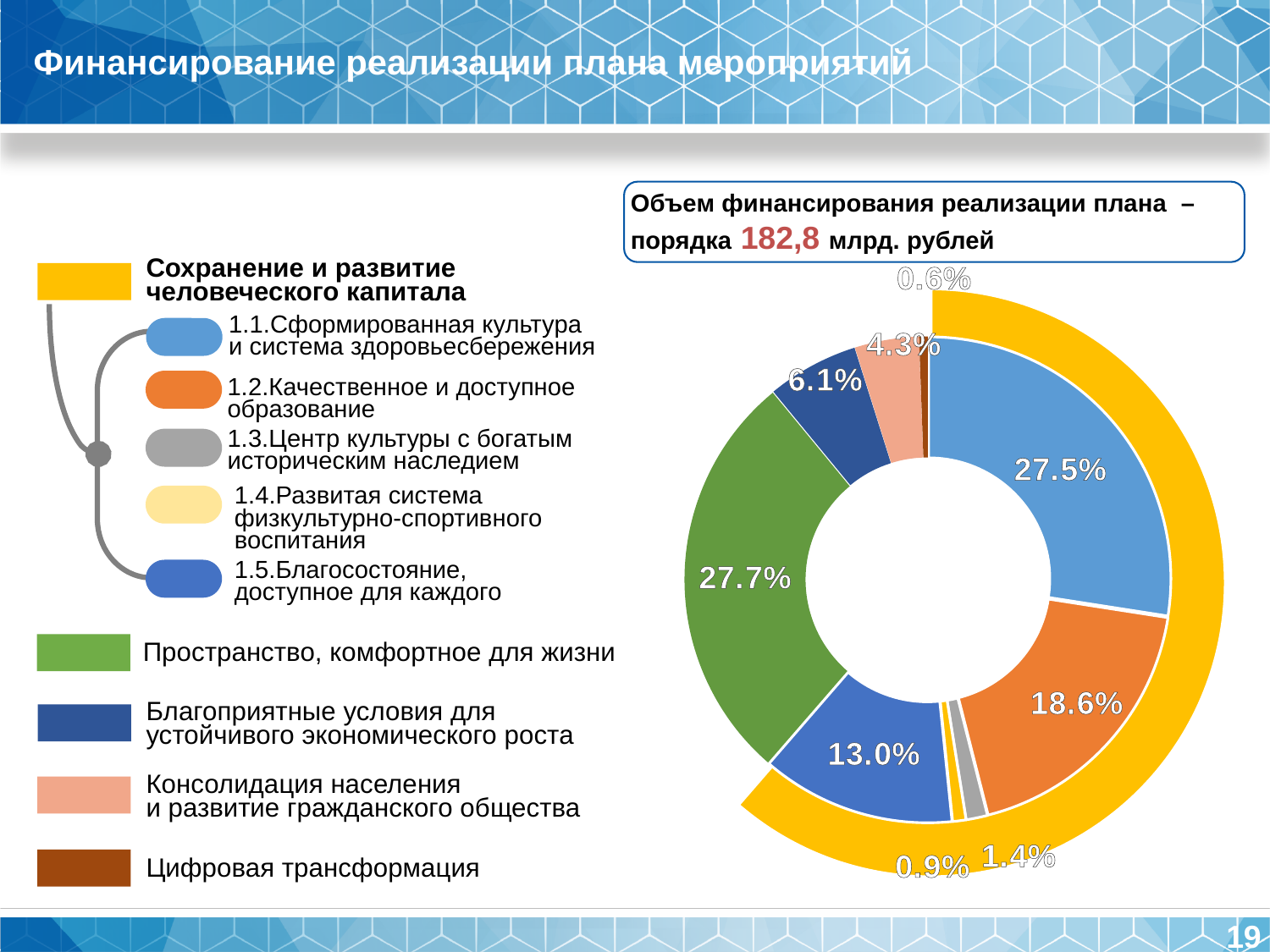
How many segments does the donut chart have? 9 What share of funding goes to "Цифровая трансформация"? 0.6% What share of funding goes to "Благоприятные условия для устойчивого экономического роста"? 6.1% What share of funding goes to "1.2.Качественное и доступное образование"? 18.6% Which is larger: the share for "Консолидация населения и развитие гражданского общества" or for "Благоприятные условия для устойчивого экономического роста"? Благоприятные условия для устойчивого экономического роста What share of funding goes to "1.5.Благосостояние, доступное для каждого"? 13.0% What type of chart is shown on the slide? Pie (donut) chart What total funding volume is stated on the slide? 182,8 млрд. рублей What is the difference between the shares for "1.2.Качественное и доступное образование" and "1.5.Благосостояние, доступное для каждого"? 5.6% What share of funding goes to "Пространство, комфортное для жизни"? 27.7% What share of funding goes to "1.1.Сформированная культура и система здоровьесбережения"? 27.5% Which segment has the smallest share in the chart? Цифровая трансформация (0.6%)